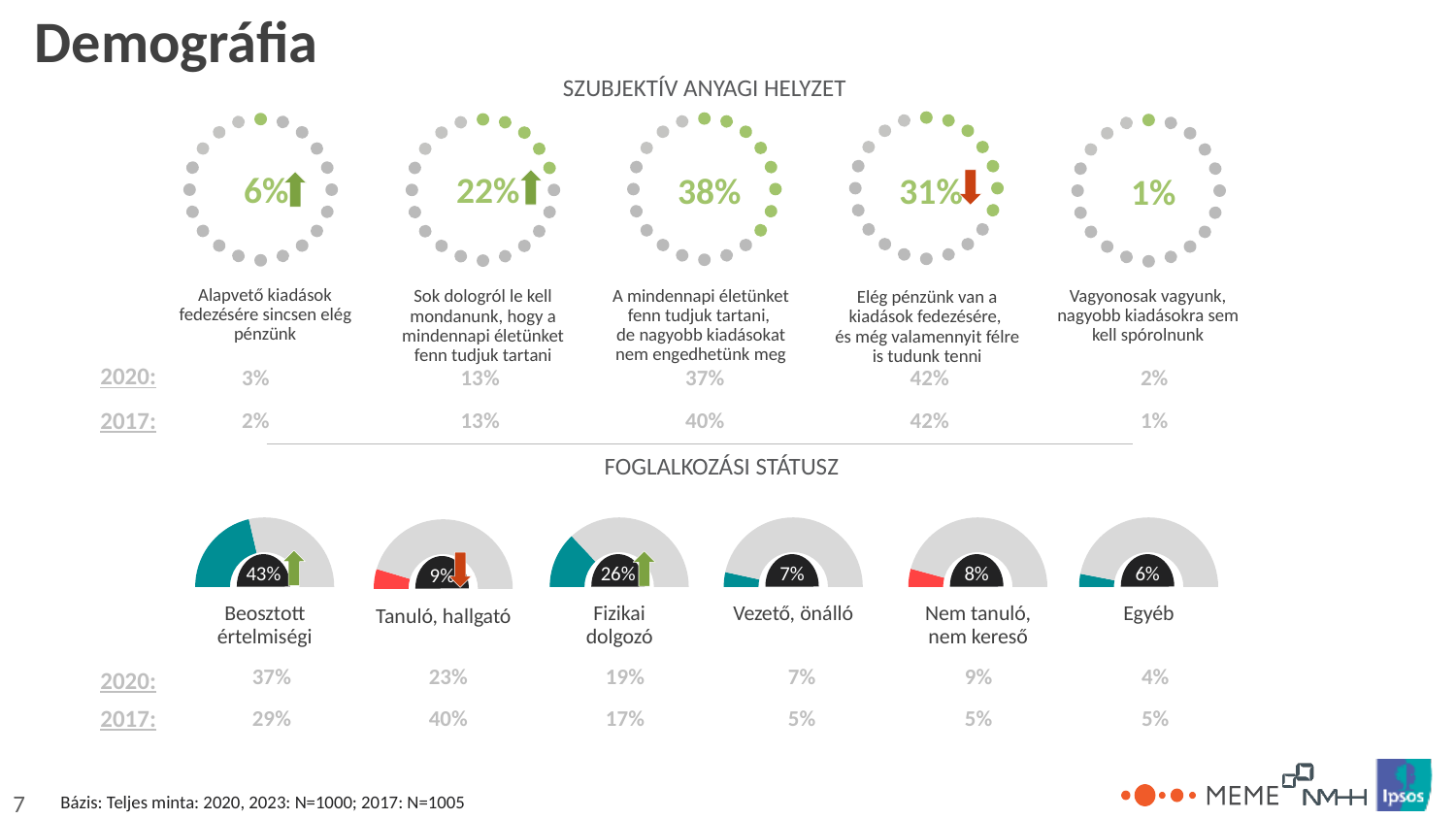
In the 'Szubjektív anyagi helyzet' section, what is the difference between the current value for 'Elég pénzünk van a kiadások fedezésére, és még valamennyit félre is tudunk tenni' (31%) and its 2020 value? 11% In the 'Szubjektív anyagi helyzet' section, what is the current value shown for 'Vagyonosak vagyunk, nagyobb kiadásokra sem kell spórolnunk'? 1% In the 'Foglalkozási státusz' section, what is the difference between the current value for 'Beosztott értelmiségi' (43%) and its 2020 value? 6% In the 'Foglalkozási státusz' section, what is the current value shown for 'Beosztott értelmiségi'? 43% In the 'Szubjektív anyagi helyzet' section, which category has the highest current value? A mindennapi életünket fenn tudjuk tartani, de nagyobb kiadásokat nem engedhetünk meg In the 'Szubjektív anyagi helyzet' section, what is the current value shown for 'A mindennapi életünket fenn tudjuk tartani, de nagyobb kiadásokat nem engedhetünk meg'? 38% In the 'Foglalkozási státusz' section, what was the 2017 value for 'Tanuló, hallgató'? 40% In the 'Foglalkozási státusz' section, which category has the lowest current value? Egyéb How many categories are shown in the 'Foglalkozási státusz' section? 6 In the 'Foglalkozási státusz' section, what is the current value shown for 'Tanuló, hallgató'? 9% In the 'Foglalkozási státusz' section, which is larger: the current value for 'Fizikai dolgozó' or for 'Nem tanuló, nem kereső'? Fizikai dolgozó How many categories are shown in the 'Szubjektív anyagi helyzet' section? 5